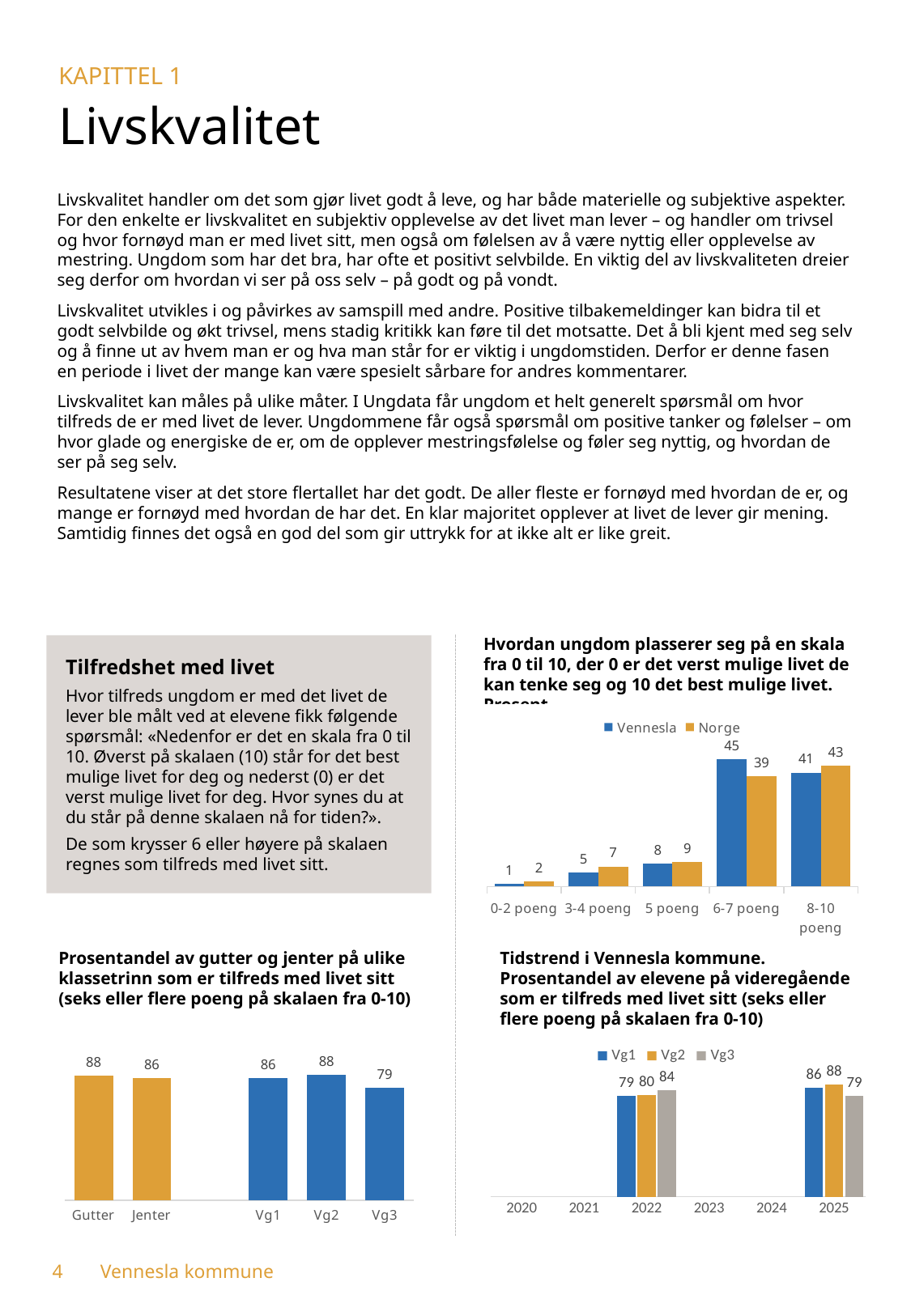
In the top-right chart 'Hvordan ungdom plasserer seg på en skala fra 0 til 10', which category has the highest value for Vennesla? 6-7 poeng In the top-right chart 'Hvordan ungdom plasserer seg på en skala fra 0 til 10', what is the value for Vennesla at 6-7 poeng? 45 What kind of chart is the bottom-left chart 'Prosentandel av gutter og jenter på ulike klassetrinn som er tilfreds med livet sitt'? Bar chart In the top-right chart 'Hvordan ungdom plasserer seg på en skala fra 0 til 10', how many categories are shown on the x axis? 5 In the bottom-left chart 'Prosentandel av gutter og jenter på ulike klassetrinn som er tilfreds med livet sitt', what is the value for Vg3? 79 In the top-right chart 'Hvordan ungdom plasserer seg på en skala fra 0 til 10', how many series does the legend list? 2 In the top-right chart 'Hvordan ungdom plasserer seg på en skala fra 0 til 10', what is the value for Norge at 8-10 poeng? 43 In the bottom-right chart 'Tidstrend i Vennesla kommune', what is the difference between the Vg1 values for 2025 and 2022? 7 In the bottom-left chart 'Prosentandel av gutter og jenter på ulike klassetrinn som er tilfreds med livet sitt', which is larger, Gutter or Jenter? Gutter In the bottom-right chart 'Tidstrend i Vennesla kommune', what is the value for Vg2 in 2025? 88 In the bottom-left chart 'Prosentandel av gutter og jenter på ulike klassetrinn som er tilfreds med livet sitt', which category has the lowest value? Vg3 In the top-right chart 'Hvordan ungdom plasserer seg på en skala fra 0 til 10', what is the difference between Vennesla and Norge at 6-7 poeng? 6